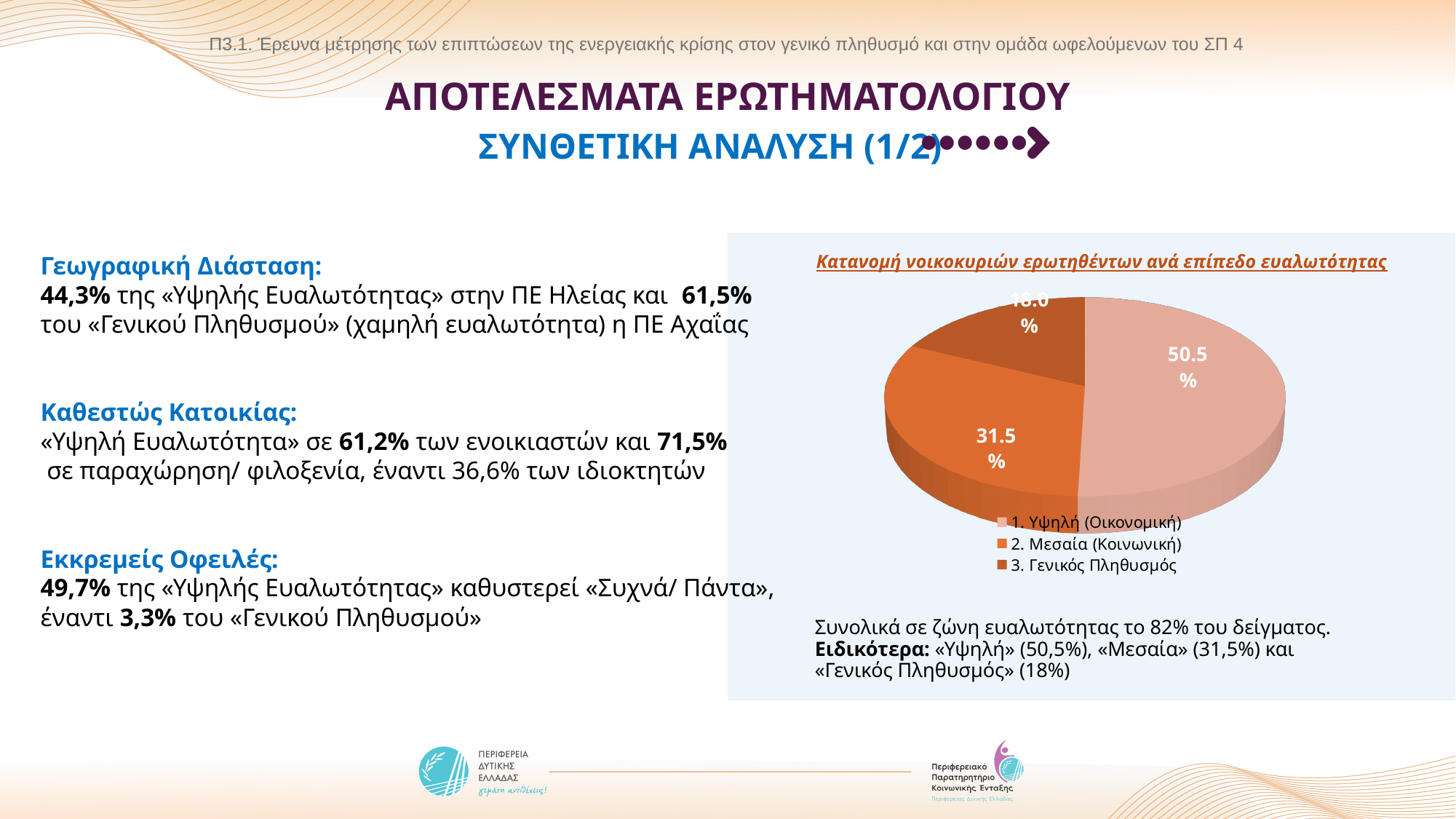
How many entries does the legend of the pie chart list? 3 What type of chart is shown on the slide? pie chart Which legend entry is shown in the lightest (pale pink) colour in the pie chart? 1. Υψηλή (Οικονομική) How many slices does the pie chart have? 3 Which category has the smallest slice in the pie chart? 3. Γενικός Πληθυσμός Which category has the largest slice in the pie chart? 1. Υψηλή (Οικονομική) What is the difference in percentage points between '1. Υψηλή (Οικονομική)' and '2. Μεσαία (Κοινωνική)'? 19.0 What share of the pie does '3. Γενικός Πληθυσμός' have? 18.0% What is the title of the chart on the slide? Κατανομή νοικοκυριών ερωτηθέντων ανά επίπεδο ευαλωτότητας What share of the pie does '2. Μεσαία (Κοινωνική)' have? 31.5% Which is larger in the pie chart: '2. Μεσαία (Κοινωνική)' or '3. Γενικός Πληθυσμός'? 2. Μεσαία (Κοινωνική) What share of the pie does '1. Υψηλή (Οικονομική)' have? 50.5%